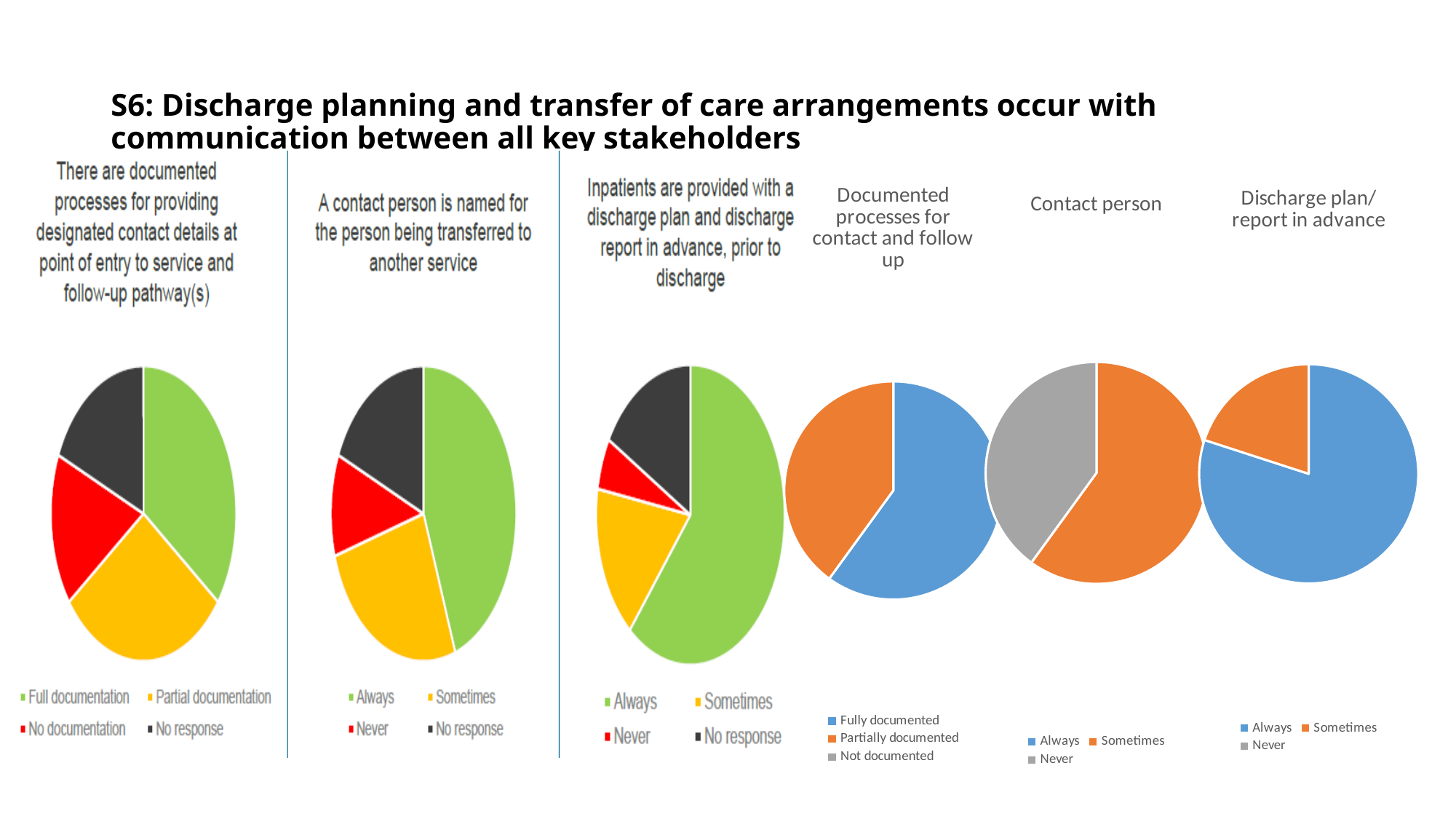
In the 'Documented processes for contact and follow up' pie chart, which category has the largest slice? Fully documented In the 'There are documented processes for providing designated contact details...' pie chart, which category has the largest slice? Full documentation In the 'Contact person' pie chart, which category has the largest slice? Sometimes In the 'There are documented processes for providing designated contact details...' pie chart, which slice is larger: Full documentation or Partial documentation? Full documentation In the 'Discharge plan/ report in advance' pie chart, which slice is larger: Always or Sometimes? Always How many categories does the legend of the 'Documented processes for contact and follow up' pie chart list? 3 How many slices are shown in the 'There are documented processes for providing designated contact details...' pie chart? 4 In the 'Inpatients are provided with a discharge plan and discharge report in advance, prior to discharge' pie chart, which category has the smallest slice? Never In the 'A contact person is named for the person being transferred to another service' pie chart, which category has the smallest slice? Never What kind of chart is used for 'A contact person is named for the person being transferred to another service'? Pie chart